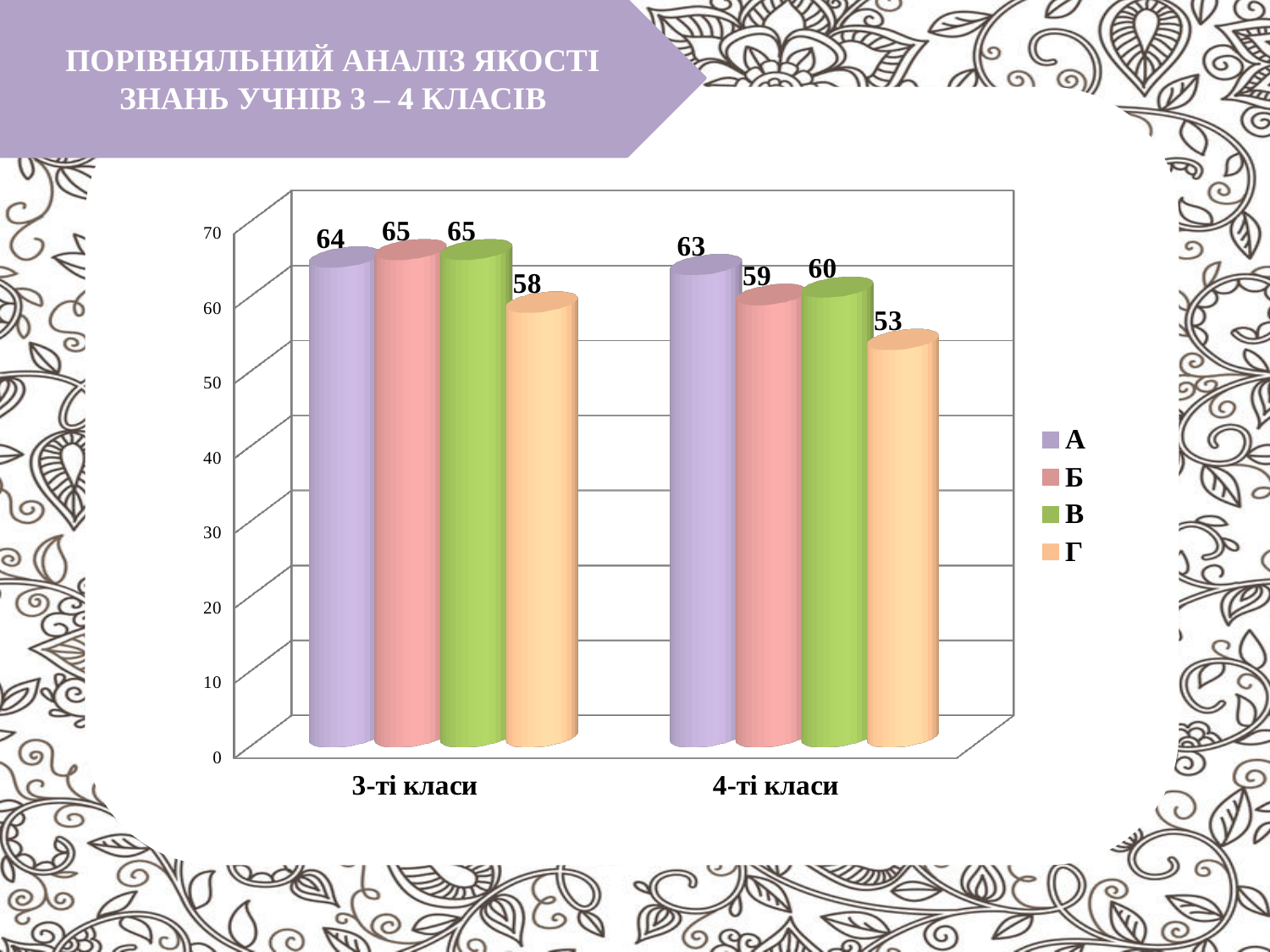
Which series has the lowest value in the 4-ті класи category? Г How many series does the legend list? 4 Which series has the lowest value in the 3-ті класи category? Г What is the value for series Г in the 4-ті класи category? 53 Which is larger: series А in 3-ті класи or series А in 4-ті класи? 3-ті класи What is the title of the slide? ПОРІВНЯЛЬНИЙ АНАЛІЗ ЯКОСТІ ЗНАНЬ УЧНІВ 3 – 4 КЛАСІВ What is the value for series В in the 4-ті класи category? 60 What is the difference between series А and series Г in the 4-ті класи category? 10 What kind of chart is shown on the slide? bar chart How many categories are shown on the x axis? 2 What is the value for series А in the 3-ті класи category? 64 What is the difference between series Б in 3-ті класи and series Б in 4-ті класи? 6